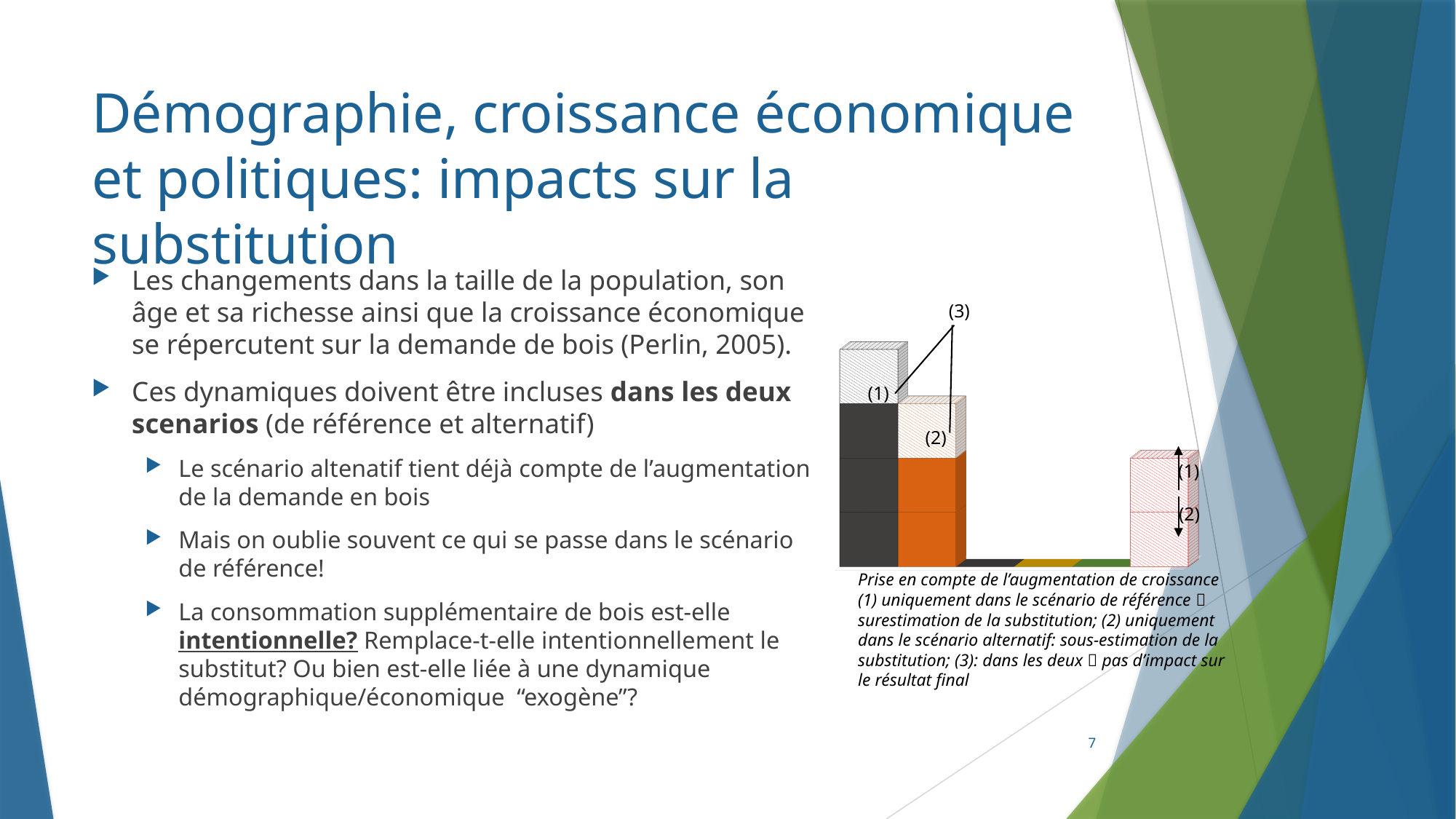
In the chart on the right, which bar is the tallest: the leftmost dark grey bar, the middle orange bar, or the rightmost pink hatched bar? the leftmost dark grey bar What kind of chart is shown on the right of the slide? bar chart How many tall bars are drawn in the chart on the right of the slide? 3 In the chart on the right, which bar is shorter: the leftmost dark grey bar or the rightmost pink hatched bar? the rightmost pink hatched bar Which numbered annotations are written on the chart on the right of the slide? (1), (2) and (3) What colour is the rightmost bar in the chart on the right of the slide? pink (hatched) In the chart on the right, is the orange bar taller or shorter than the dark grey bar next to it? shorter